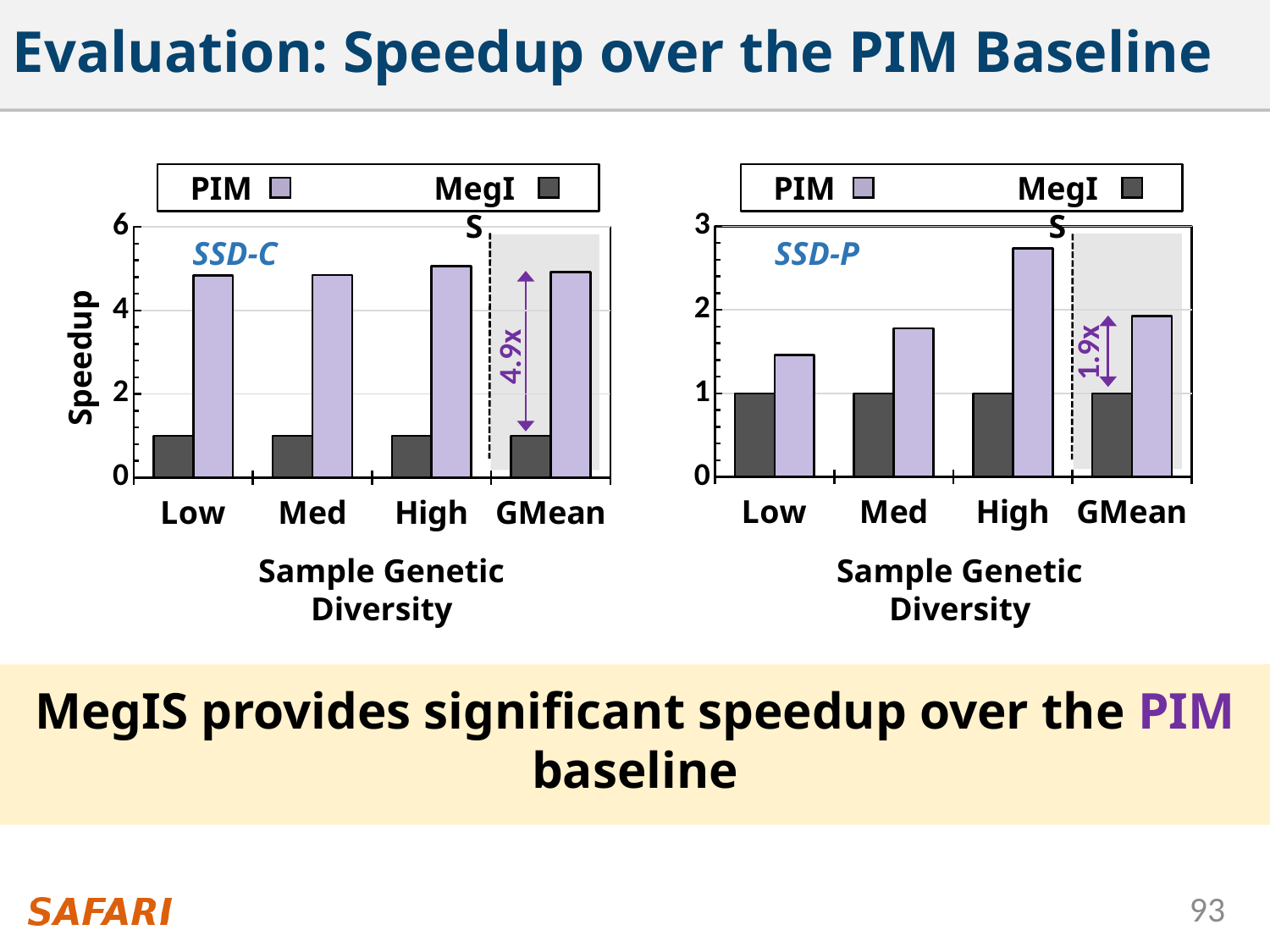
In the SSD-C chart, what speedup factor is annotated on the GMean bars? 4.9x In the SSD-P chart, is the light purple bar for Low greater or less than 2? less What is the y-axis label of the SSD-C chart? Speedup In the SSD-C chart, is the light purple bar for High greater or less than 4? greater In the SSD-P chart, which category has the tallest light purple bar? High In the SSD-P chart, do the light purple bars rise or fall from Low to High? rise How many categories are shown on the x axis of the SSD-C chart? 4 In the SSD-P chart, what speedup factor is annotated on the GMean bars? 1.9x What kind of chart is the SSD-C chart on the left? bar chart How many series does the legend of the SSD-P chart list? 2 What are the two series named in the legend of the SSD-C chart? PIM and MegIS In the SSD-P chart, is the light purple bar for High greater or less than 2? greater